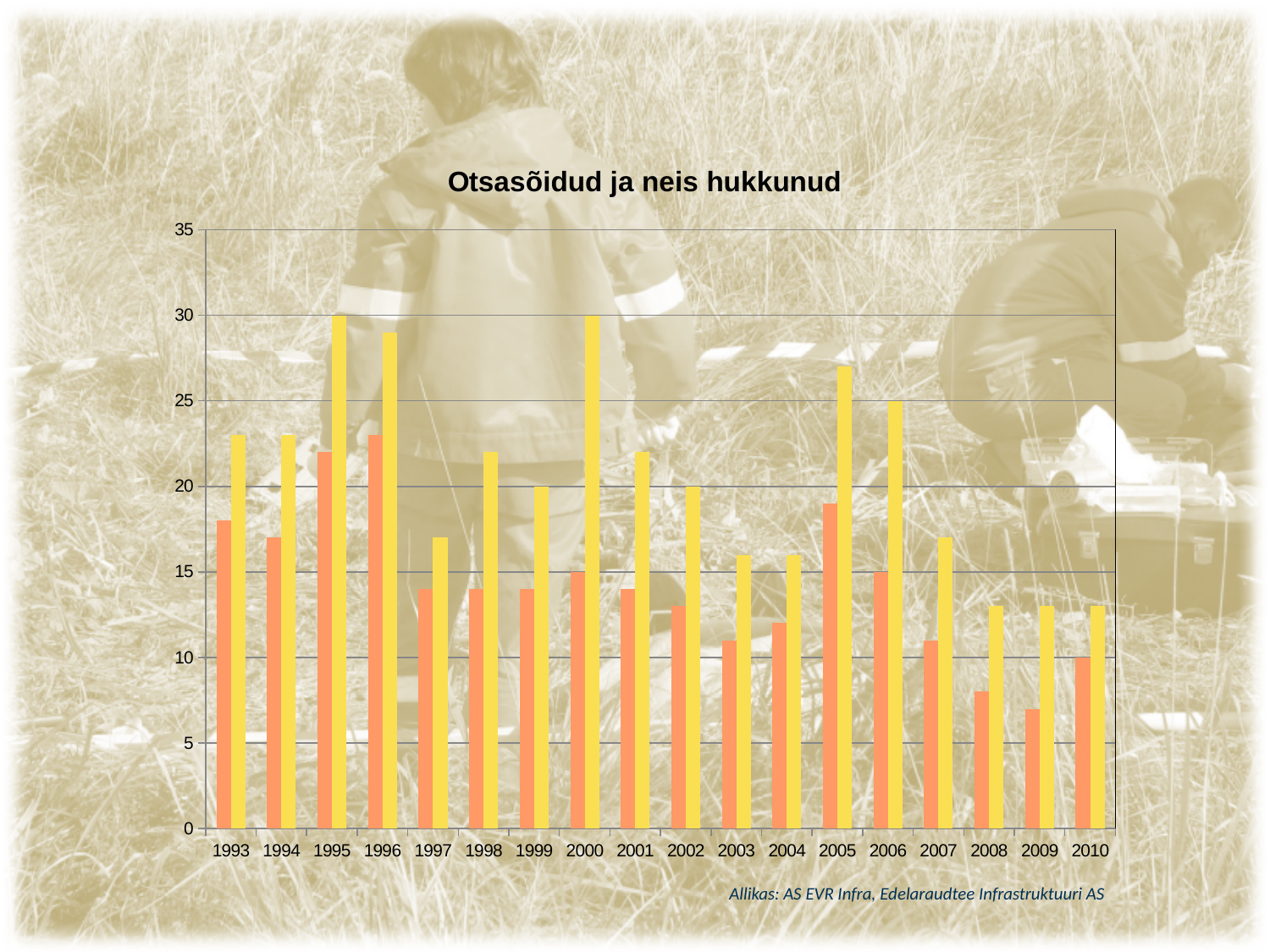
How many bars are plotted for each year in the chart? 2 What value does the yellow bar for 1995 reach? 30 What kind of chart is shown on the slide? bar chart Is the yellow bar for 2005 greater or less than 25? greater Is the orange bar for 1993 greater or less than 15? greater What is the title of the chart? Otsasõidud ja neis hukkunud Which is larger, the yellow bar for 1996 or the yellow bar for 1997? 1996 Is the orange bar for 2009 greater or less than 10? less How many years are shown on the x axis of the chart? 18 What value does the yellow bar for 2000 reach? 30 What value does the orange bar for 2010 reach? 10 Do the yellow bars rise or fall from 2005 to 2010? fall